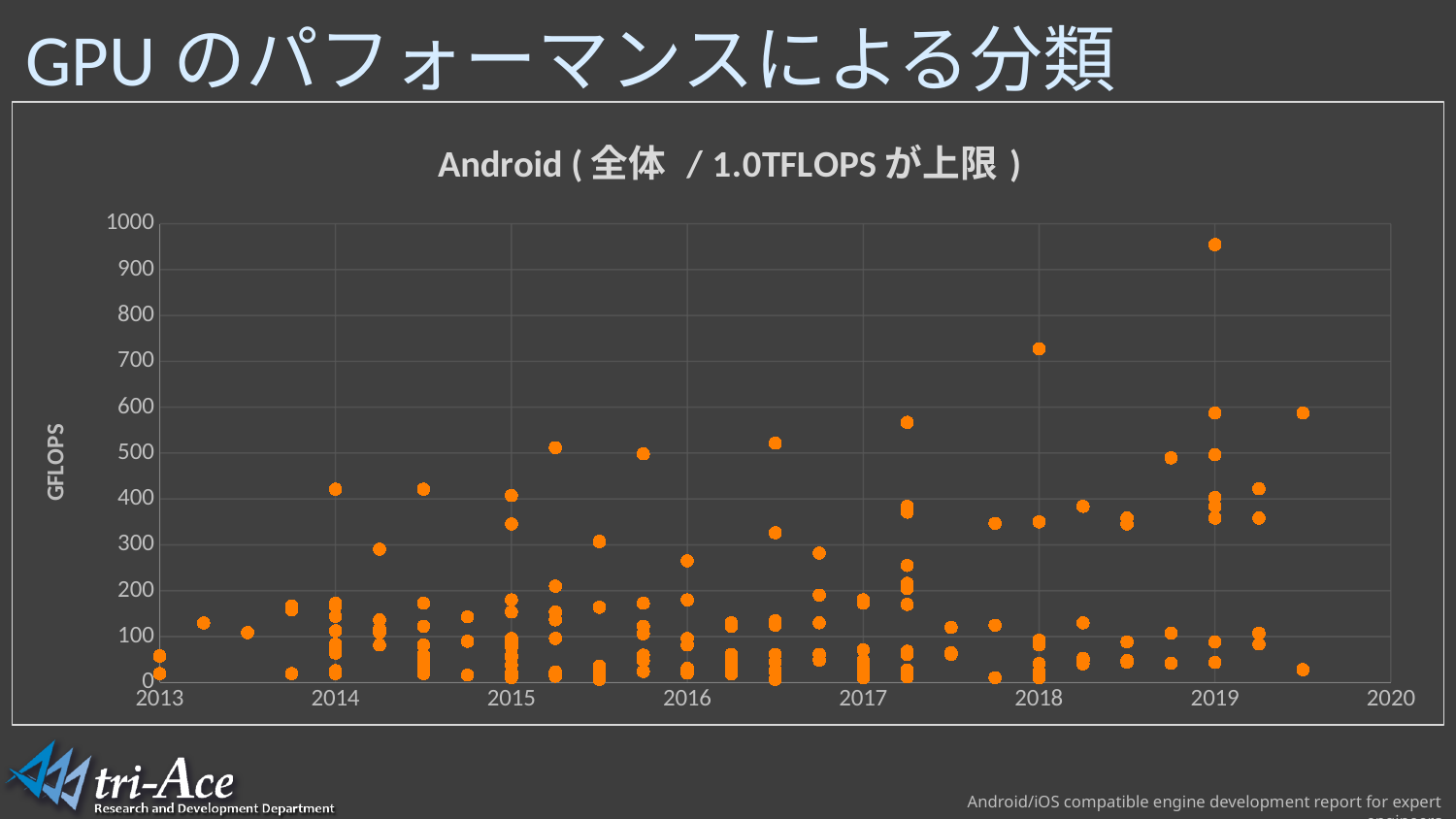
Is the value of the highest point plotted near 2018 greater or less than 700? greater Do the highest plotted values generally rise or fall from 2013 to 2019? rise Is the value of the highest point plotted near 2019 greater or less than 900? greater What kind of chart is shown on the slide? scatter chart Is the value of the highest point plotted near 2017 greater or less than 500? greater Which year has a higher maximum plotted value, 2018 or 2019? 2019 Around which year on the x axis does the highest plotted point appear? 2019 What is the label of the vertical axis? GFLOPS What is the title of the chart? Android ( 全体 / 1.0TFLOPS が上限 ) What is the maximum value shown on the vertical axis? 1000